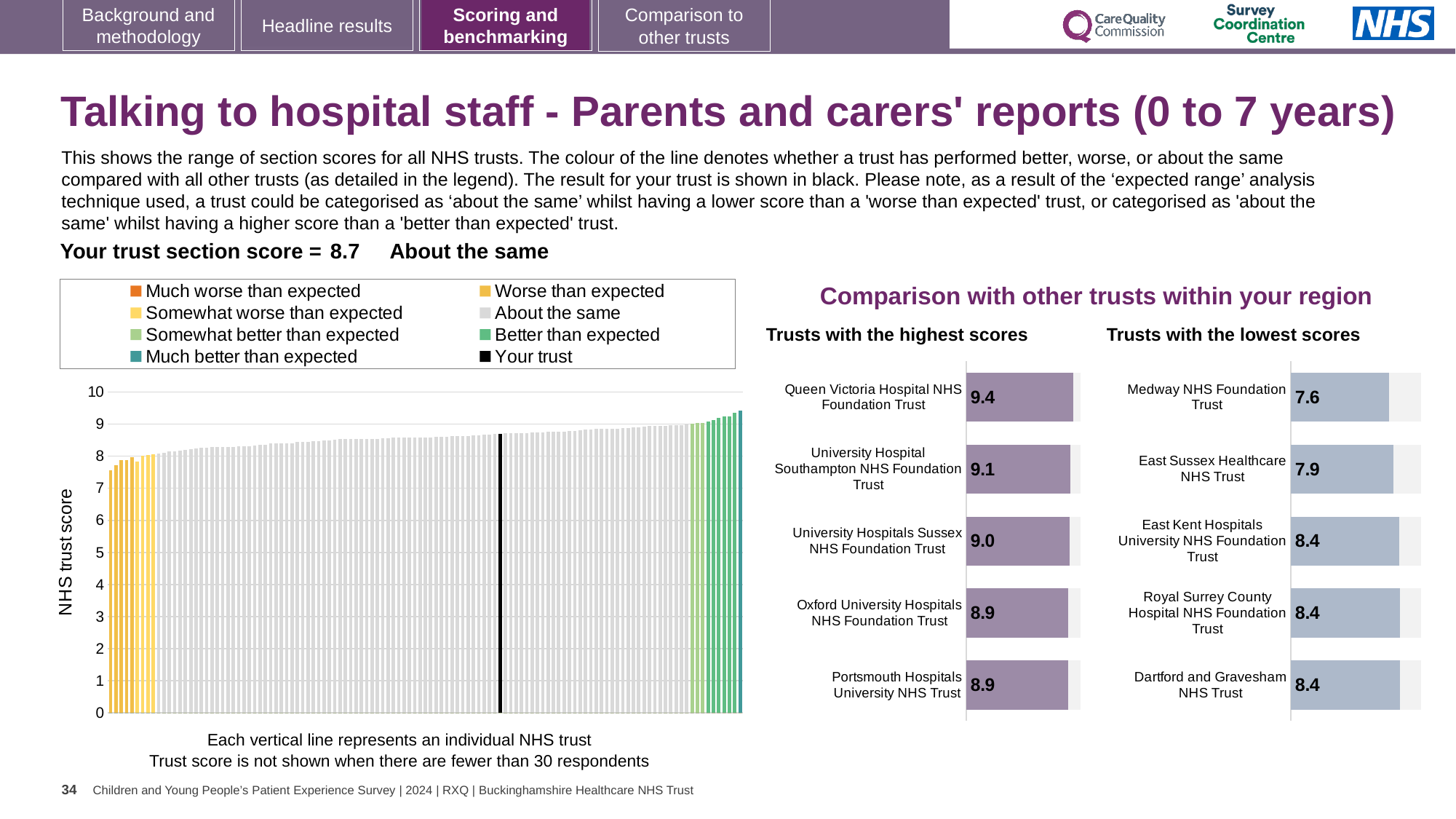
In the 'Trusts with the lowest scores' chart, which trust has the lowest score? Medway NHS Foundation Trust In the 'Trusts with the lowest scores' chart, how many trusts are shown? 5 In the 'Trusts with the lowest scores' chart, what is the score for Medway NHS Foundation Trust? 7.6 In the large chart on the left, is the value of the leftmost bar greater or less than 8? less In the large chart on the left, do the trust scores rise or fall from left to right? Rise In the 'Trusts with the highest scores' chart, what is the score for Queen Victoria Hospital NHS Foundation Trust? 9.4 In the 'Trusts with the highest scores' chart, which trust has the highest score? Queen Victoria Hospital NHS Foundation Trust In the 'Trusts with the highest scores' chart, what is the difference between the scores of Queen Victoria Hospital NHS Foundation Trust and Portsmouth Hospitals University NHS Trust? 0.5 In the large chart on the left, how many entries does the legend list? 8 In the 'Trusts with the highest scores' chart, how many trusts are shown? 5 In the 'Trusts with the lowest scores' chart, which has the larger score: Medway NHS Foundation Trust or East Sussex Healthcare NHS Trust? East Sussex Healthcare NHS Trust What kind of chart is the large chart on the left showing NHS trust scores? Bar chart